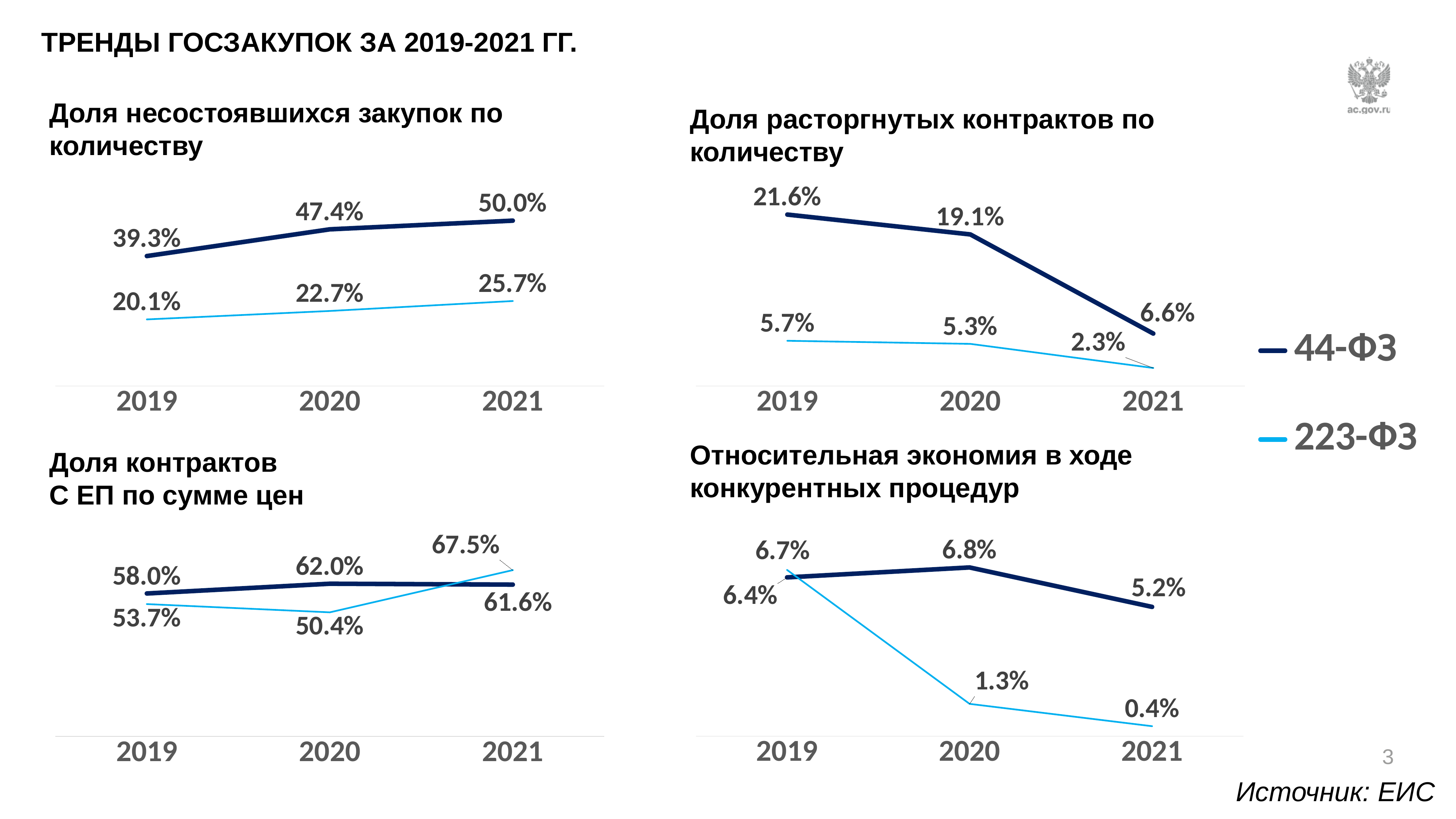
How many series does the legend on the slide list? 2 In the chart 'Доля несостоявшихся закупок по количеству', does the 44-ФЗ line rise or fall from 2019 to 2021? rise In the chart 'Доля расторгнутых контрактов по количеству', in which year is the 223-ФЗ value lowest? 2021 In the chart 'Доля контрактов с ЕП по сумме цен', what is the value for 223-ФЗ in 2021? 67.5% What kind of chart is 'Доля несостоявшихся закупок по количеству'? line chart In the chart 'Доля расторгнутых контрактов по количеству', what is the value for 44-ФЗ in 2020? 19.1% In the chart 'Доля контрактов с ЕП по сумме цен', which is larger in 2020: 44-ФЗ or 223-ФЗ? 44-ФЗ In the chart 'Доля расторгнутых контрактов по количеству', what is the difference between the 44-ФЗ and 223-ФЗ values in 2021? 4.3% In the chart 'Относительная экономия в ходе конкурентных процедур', what is the value for 223-ФЗ in 2020? 1.3% In the chart 'Доля несостоявшихся закупок по количеству', what is the value for 44-ФЗ in 2021? 50.0% In the chart 'Доля несостоявшихся закупок по количеству', what is the value for 223-ФЗ in 2019? 20.1% In the chart 'Относительная экономия в ходе конкурентных процедур', in which year is the 44-ФЗ value highest? 2020